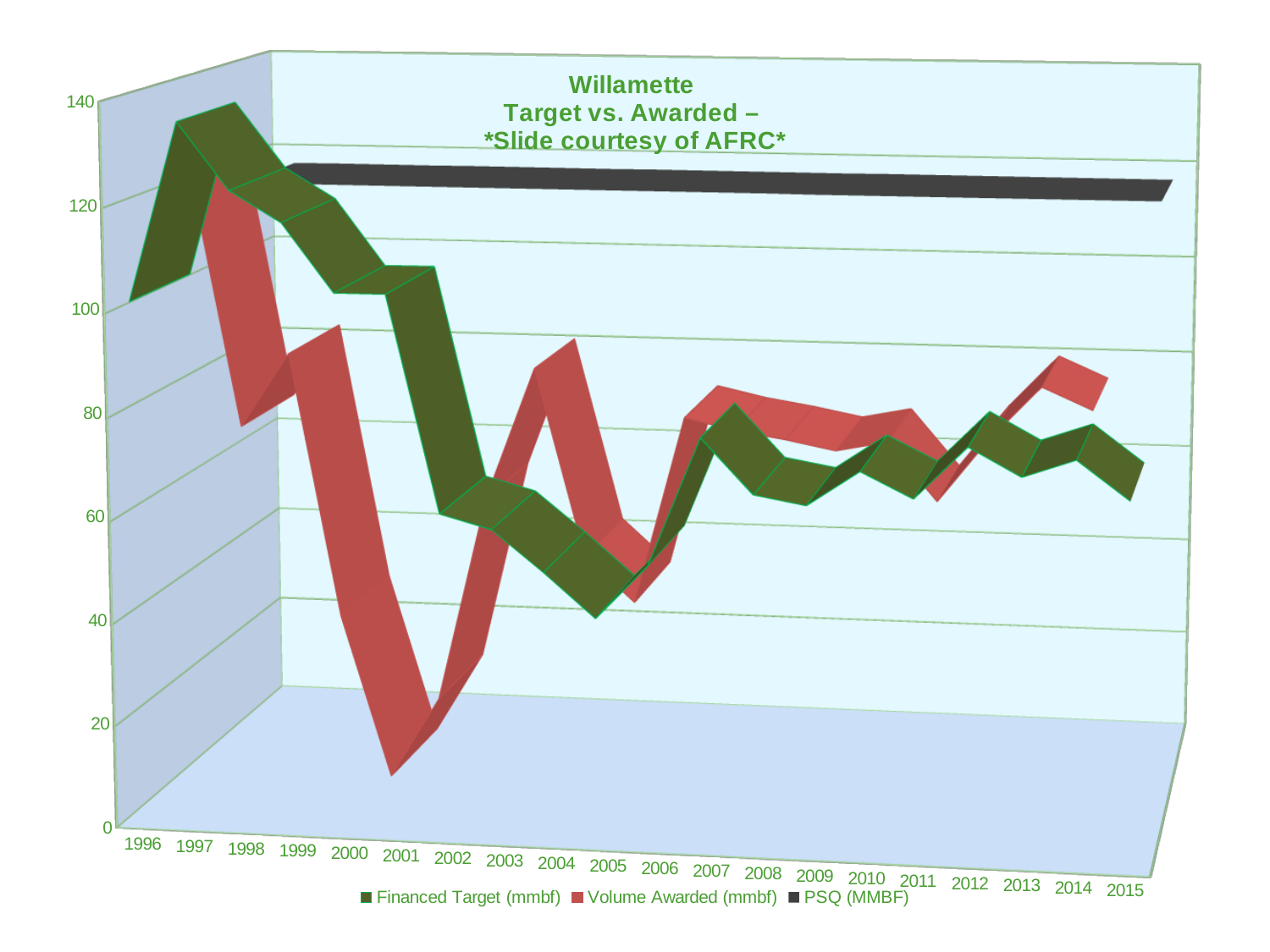
What kind of chart is shown on the slide? line chart Which colour represents the Volume Awarded (mmbf) series? red Is the value of Financed Target (mmbf) in 1997 greater or less than 120? greater In 2001, which is larger: Financed Target (mmbf) or Volume Awarded (mmbf)? Financed Target (mmbf) In which year is Financed Target (mmbf) at its highest? 1997 What is the first line of the chart title? Willamette Is the value of Financed Target (mmbf) in 2005 greater or less than 60? less In which year is Volume Awarded (mmbf) at its lowest? 2000 How many years are shown along the x axis? 20 How many series does the legend list? 3 Does the Financed Target (mmbf) series rise or fall from 1997 to 2001? fall